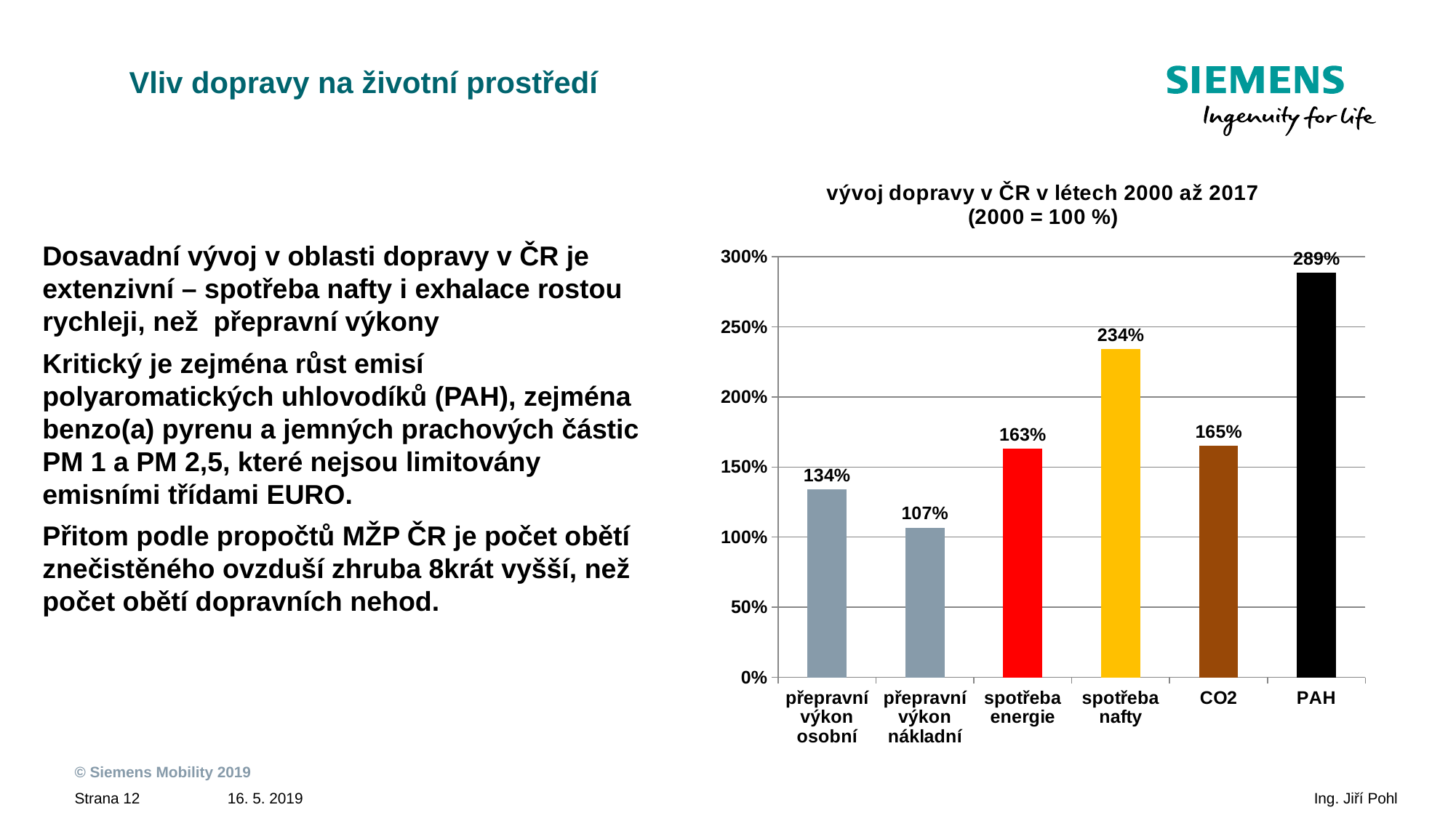
What is the title of the chart? vývoj dopravy v ČR v létech 2000 až 2017 (2000 = 100 %) How many categories are shown on the x axis? 6 What is the value for přepravní výkon nákladní? 107% Which category has the lowest value? přepravní výkon nákladní Is the value for spotřeba energie greater or less than 150%? greater What is the difference between the values for PAH and přepravní výkon osobní? 155% What is the value for CO2? 165% Which category has the highest value? PAH What is the value for spotřeba nafty? 234% What kind of chart is shown? bar chart Which is larger, the value for spotřeba energie or the value for spotřeba nafty? spotřeba nafty What is the value for PAH? 289%